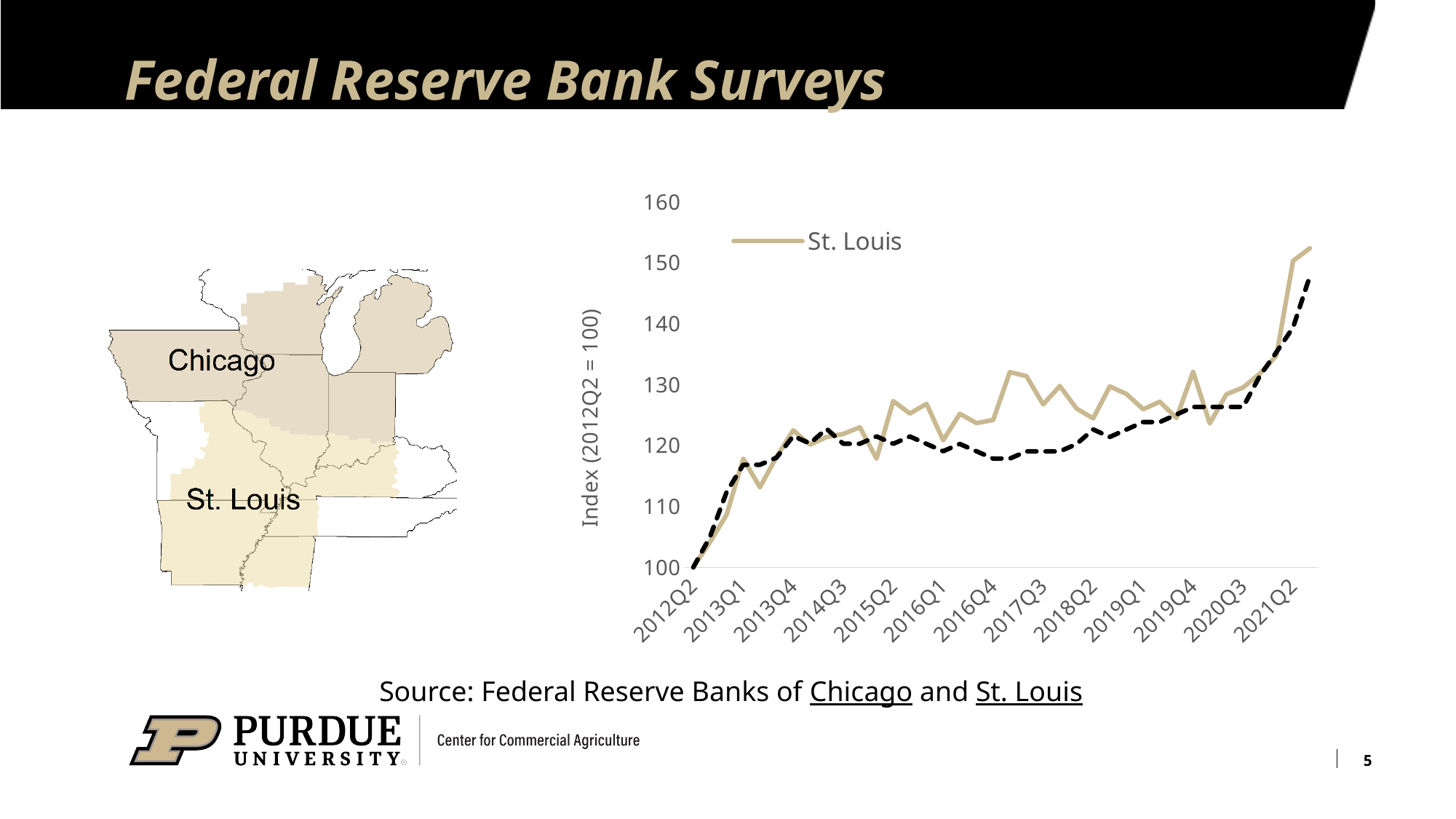
What is the label on the vertical axis of the chart? Index (2012Q2 = 100) Is the final value of the St. Louis series greater or less than 150? greater What is the value of the St. Louis series at 2012Q2? 100 What type of chart is shown on the slide? line chart Which series name is shown in the chart's legend? St. Louis At 2017Q3, which is higher: the St. Louis line or the dashed black line? St. Louis How many quarter labels are shown on the x axis? 13 What is the highest tick value shown on the vertical axis? 160 At 2018Q2, which is higher: the St. Louis line or the dashed black line? St. Louis Is the value of the dashed black line at 2016Q4 greater or less than 120? less Does the St. Louis series overall rise or fall from 2012Q2 to 2021Q2? rise What is the last quarter label shown on the x axis? 2021Q2